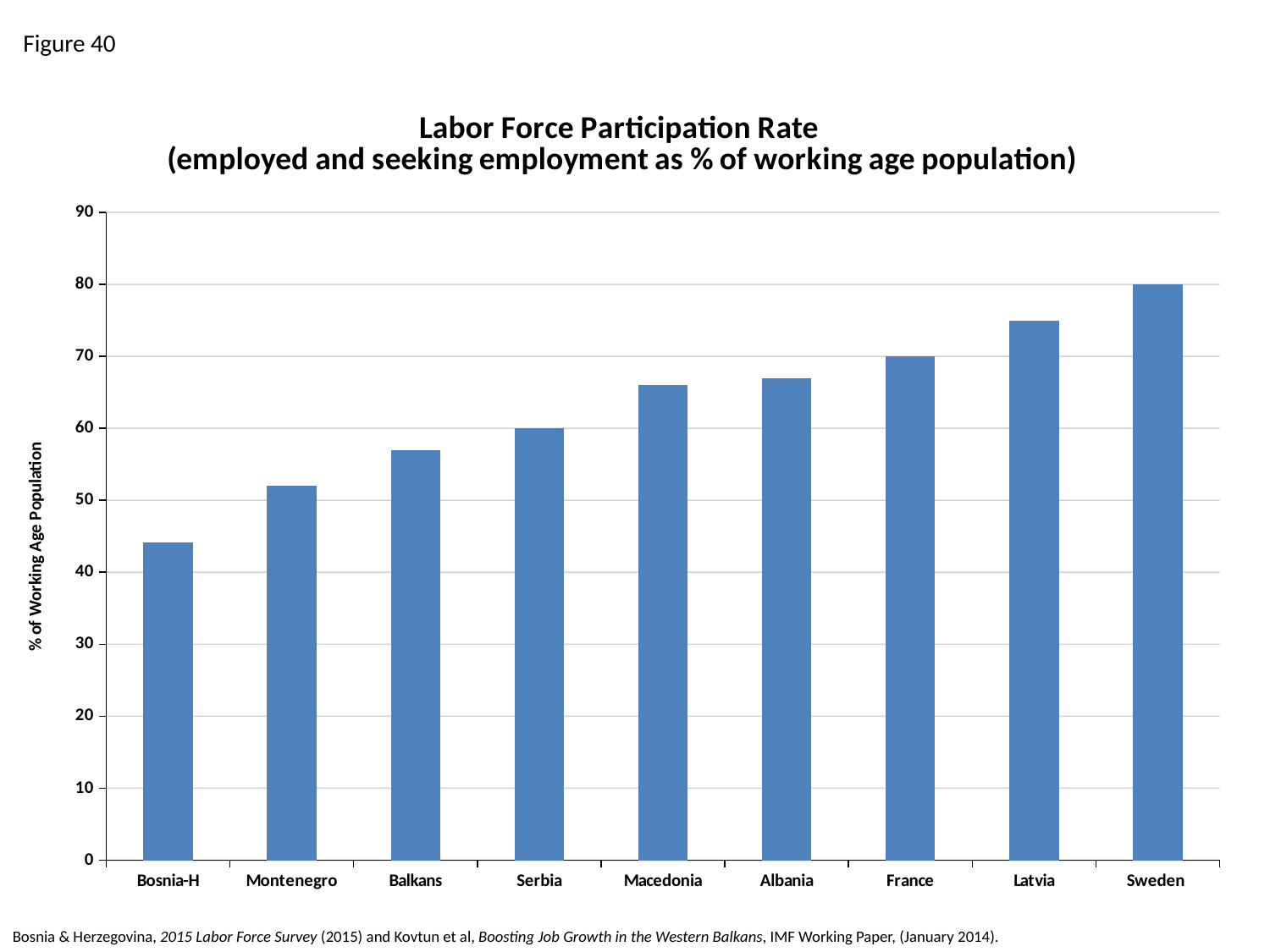
What type of chart is shown on the slide? bar chart Which category has the lowest labor force participation rate? Bosnia-H Which category has the highest labor force participation rate? Sweden What is the labor force participation rate for Serbia? 60 Which has a higher labor force participation rate, Latvia or Albania? Latvia How many countries/regions are shown on the x axis of the chart? 9 Is the value for Latvia greater or less than 70? greater What is the difference between the labor force participation rates of Sweden and France? 10 Is the value for Bosnia-H greater or less than 50? less What is the labor force participation rate for France? 70 Do the values rise or fall moving from left to right along the x axis? rise What is the labor force participation rate for Sweden? 80